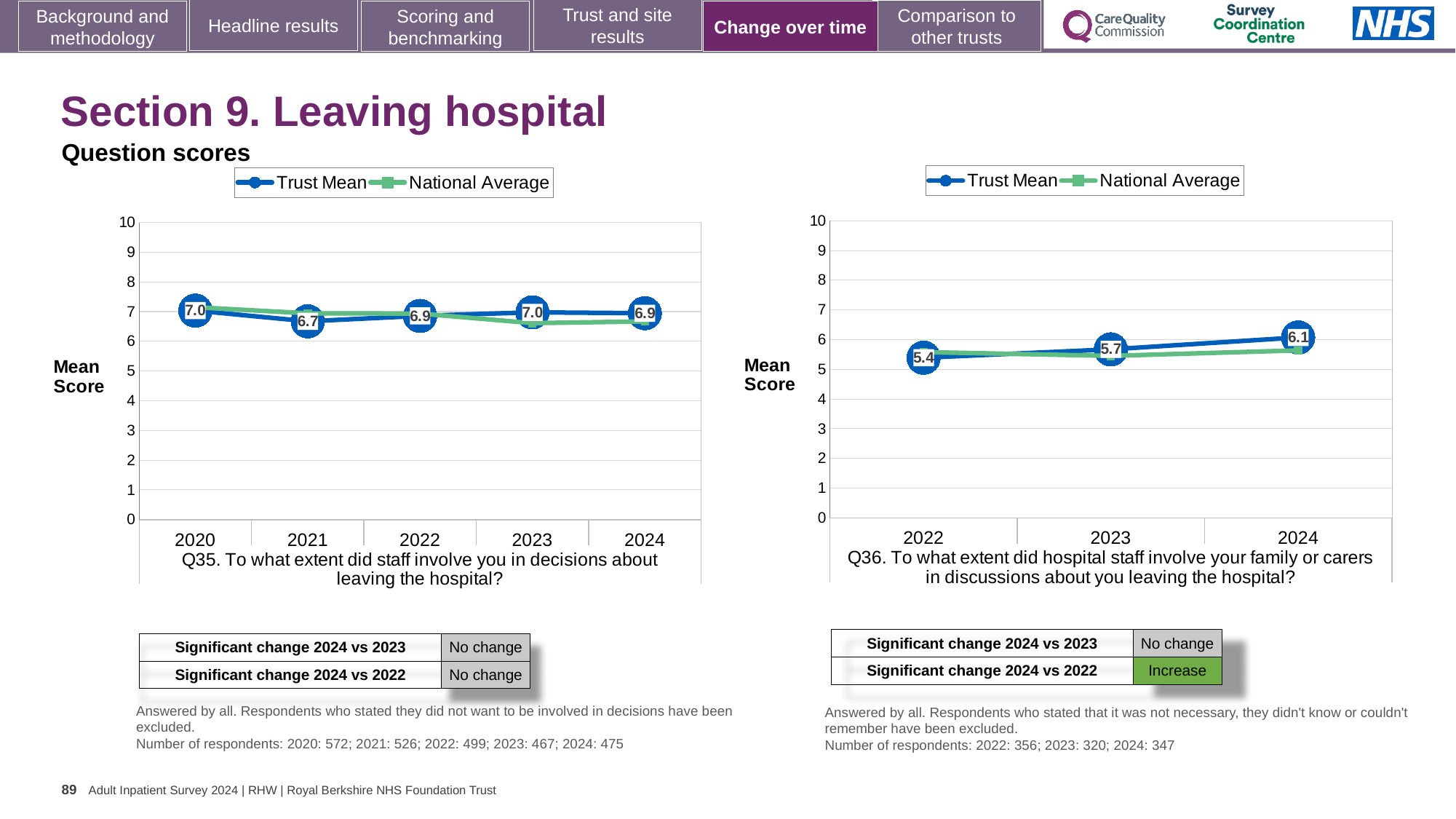
On the Q35 chart (left), what is the Trust Mean score for 2024? 6.9 How many years are plotted on the Q35 chart (left)? 5 On the Q36 chart (right), what is the difference between the Trust Mean scores for 2024 and 2022? 0.7 How many series does the legend of the Q36 chart (right) list? 2 On the Q36 chart (right), what is the Trust Mean score for 2024? 6.1 On the Q35 chart (left), which year has the lowest Trust Mean score? 2021 On the Q35 chart (left), what is the Trust Mean score for 2021? 6.7 On the Q36 chart (right), what is the Trust Mean score for 2022? 5.4 On the Q36 chart (right), which year has the highest Trust Mean score? 2024 On the Q36 chart (right), does the Trust Mean score rise or fall from 2022 to 2024? rise What type of chart is the Q35 chart (left)? line chart On the Q35 chart (left), is the Trust Mean score for 2023 higher or lower than for 2021? higher